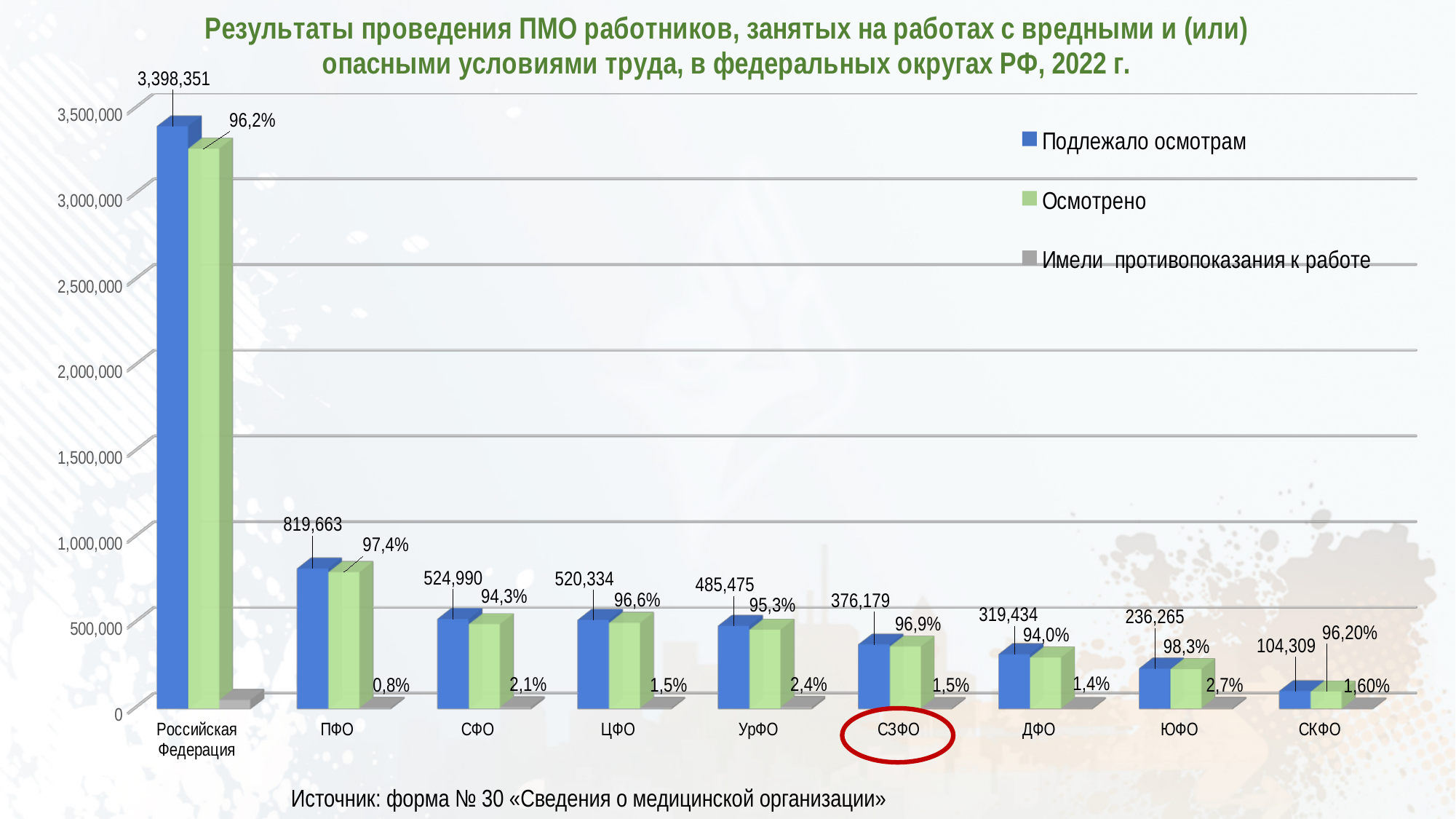
What percentage is labelled on the "Осмотрено" bar for ЮФО? 98,3% What is the difference between the "Подлежало осмотрам" values for СФО and ЦФО? 4,656 Which has a larger "Подлежало осмотрам" value, ДФО or ЮФО? ДФО What is the value of "Подлежало осмотрам" for Российская Федерация? 3,398,351 Which category has the lowest value of "Подлежало осмотрам"? СКФО What kind of chart is shown on the slide? bar chart What percentage is labelled on the "Осмотрено" bar for СЗФО? 96,9% How many categories are shown along the x axis? 9 How many series does the legend list? 3 Which category label on the x axis is circled in red? СЗФО Is the "Подлежало осмотрам" value for ПФО greater or less than 1,000,000? less What is the value of "Подлежало осмотрам" for ПФО? 819,663